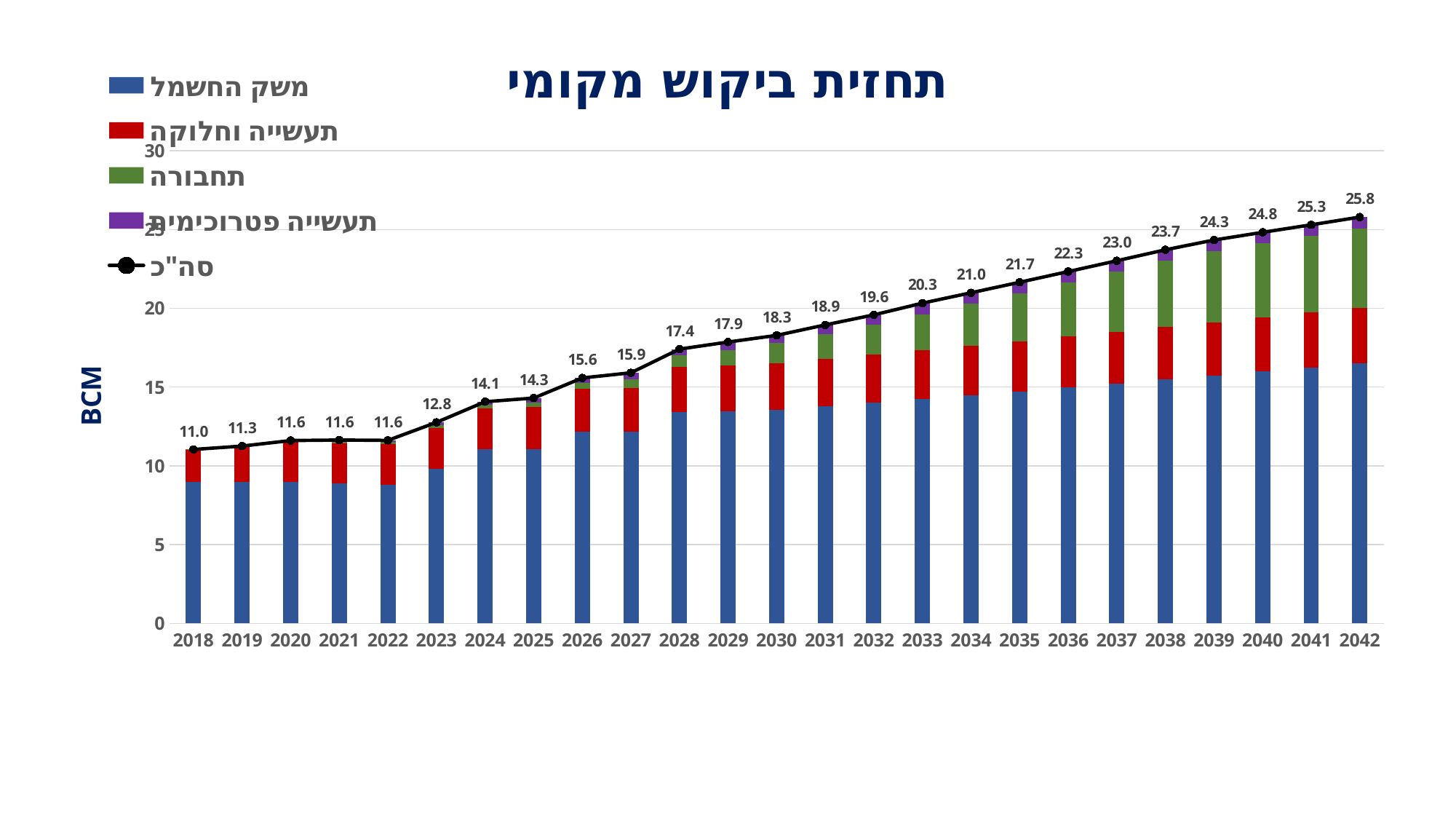
Is the value of the משק החשמל segment for 2042 greater or less than 15? greater What is the difference between the total for 2042 and the total for 2018? 14.8 How many years are shown on the x axis? 25 Do the total values rise or fall from 2018 to 2042? Rise What kind of chart is shown on the slide? Stacked bar chart with a line How many series does the legend list? 5 Which year has the lowest total value? 2018 What is the total (סה"כ) value for 2030? 18.3 What is the total (סה"כ) value for 2042? 25.8 What is the total (סה"כ) value for 2018? 11.0 Which year has the highest total value? 2042 Which year has a larger total, 2028 or 2035? 2035